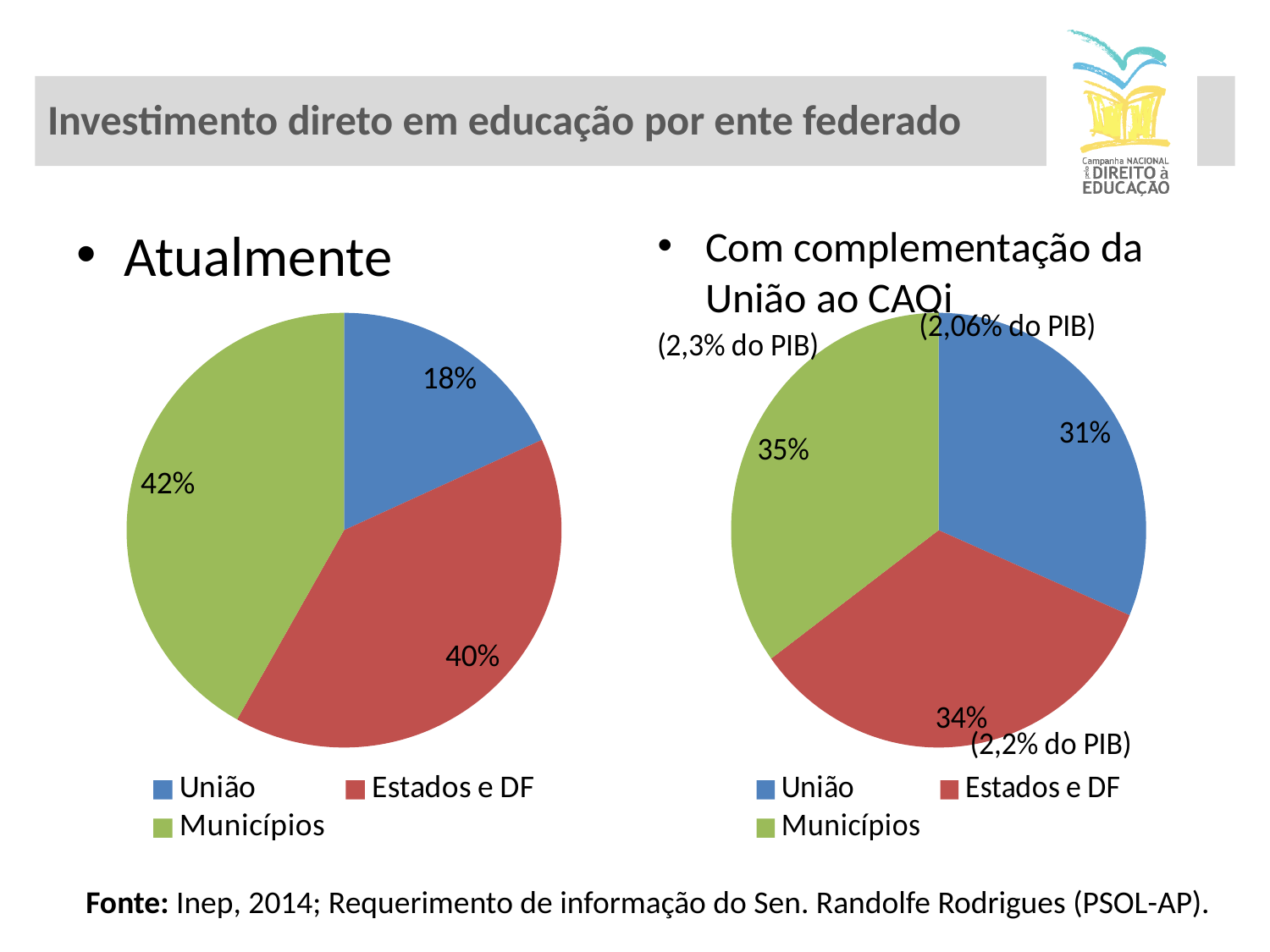
In the 'Atualmente' pie chart, what share does União have? 18% In the 'Atualmente' pie chart, what is the difference between the shares of Municípios and União? 24% In the 'Com complementação da União ao CAQi' pie chart, which category has the smallest share? União In the 'Atualmente' pie chart, what share do Estados e DF have? 40% In the 'Com complementação da União ao CAQi' pie chart, what share does União have? 31% In the 'Atualmente' pie chart, which category has the largest share? Municípios What type of chart is used on the left ('Atualmente') side of the slide? Pie chart In the 'Com complementação da União ao CAQi' pie chart, what share do Estados e DF have? 34% Which colour represents Municípios in both pie charts? Green How many categories does the legend of the 'Atualmente' pie chart list? 3 In the 'Com complementação da União ao CAQi' pie chart, what share do Municípios have? 35% In the 'Atualmente' pie chart, which category has the smallest share? União